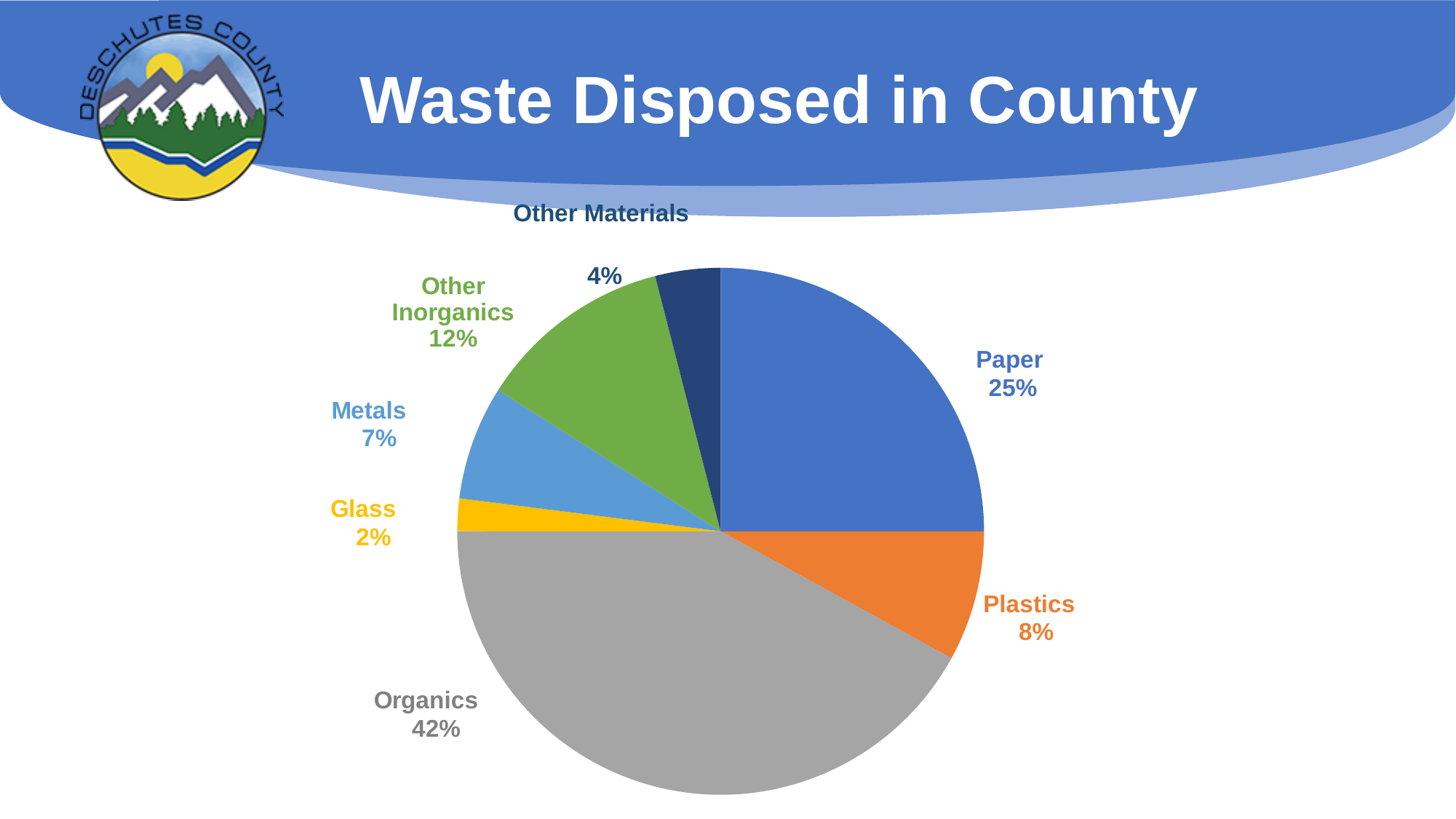
Which category has the smallest slice of the pie? Glass Which is larger, Metals or Plastics? Plastics What kind of chart is shown on the slide? Pie chart Which category has the largest slice of the pie? Organics What share of waste disposed in the county is Organics? 42% How many categories are shown in the pie chart? 7 What is the difference in percentage points between Organics and Paper? 17 What percentage of the pie is Paper? 25% What is the value shown for Plastics? 8% What is the title of the slide containing the chart? Waste Disposed in County What share does Other Materials have? 4% What percentage is labelled for Other Inorganics? 12%